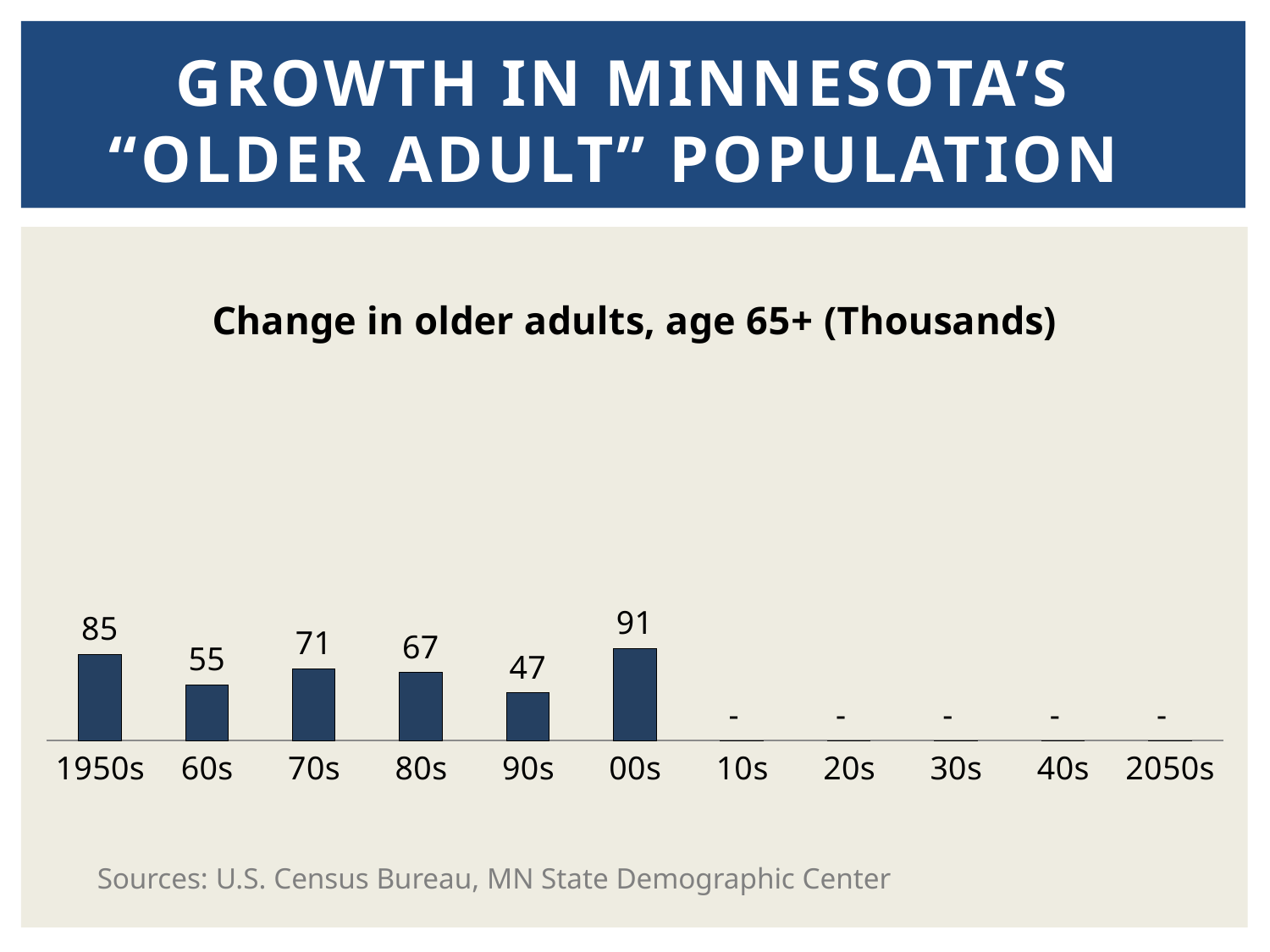
What is the value for the 70s? 71 How many decade categories are shown on the x axis? 11 What is the value for the 90s? 47 What is the value for the 1950s? 85 What is the value for the 00s? 91 What is the title of the chart? Change in older adults, age 65+ (Thousands) Which decade has the lowest value among those with a plotted bar? 90s What kind of chart is shown on the slide? Bar chart Which decade has the highest value among those with a plotted bar? 00s What is the difference between the values for the 00s and the 90s? 44 Which is larger, the value for the 70s or the value for the 80s? 70s What is the difference between the values for the 1950s and the 60s? 30